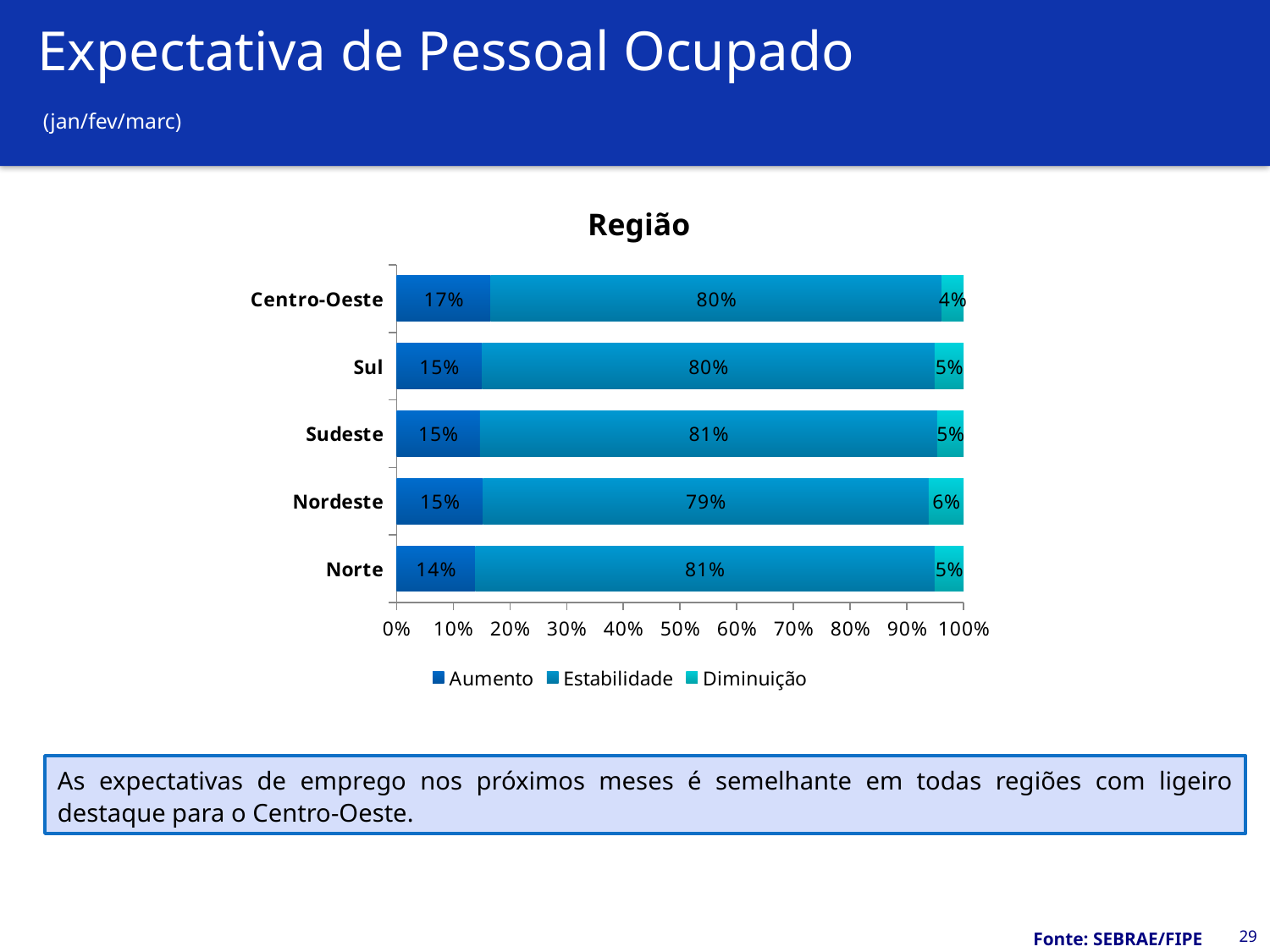
How many series does the legend list? 3 Which region has the highest Aumento value? Centro-Oeste Which region has the lowest Aumento value? Norte What is the Diminuição value for Norte? 5% What type of chart is shown on the slide? Stacked bar chart Which region has the lowest Estabilidade value? Nordeste Which region has the highest Diminuição value? Nordeste What is the Aumento value for Centro-Oeste? 17% What is the difference between the Aumento values for Centro-Oeste and Norte? 3% How many regions are shown in the chart? 5 What is the Estabilidade value for Nordeste? 79% Which is larger, the Diminuição value for Nordeste or for Centro-Oeste? Nordeste